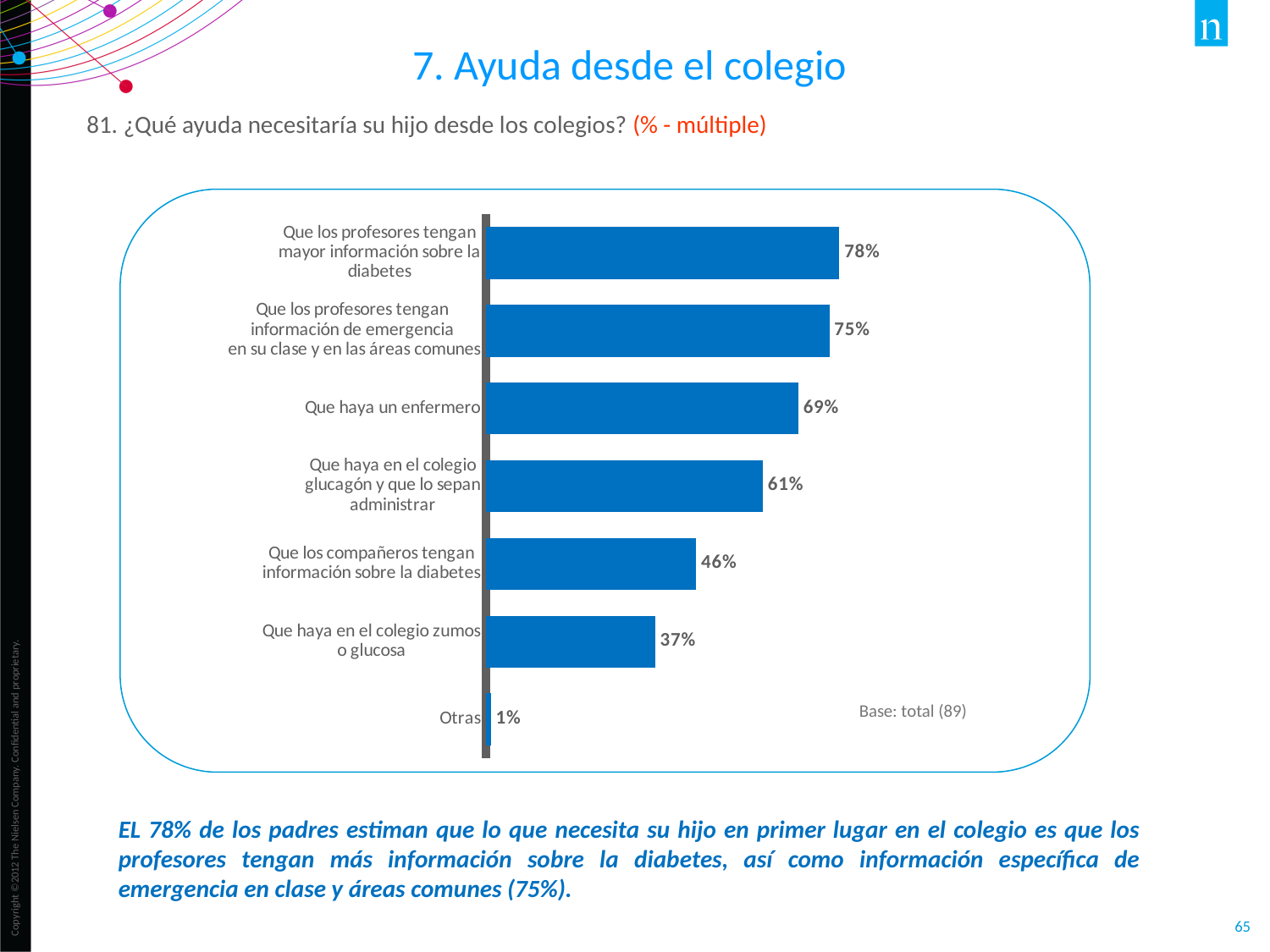
What is the value for "Otras"? 1% What base (sample size) is stated on the chart? total (89) Which category has the lowest value? Otras What is the value for "Que haya en el colegio zumos o glucosa"? 37% What is the value for "Que los compañeros tengan información sobre la diabetes"? 46% What is the difference between "Que haya un enfermero" and "Que haya en el colegio glucagón y que lo sepan administrar"? 8% What is the difference between "Que los profesores tengan mayor información sobre la diabetes" and "Que los profesores tengan información de emergencia en su clase y en las áreas comunes"? 3% How many categories are shown in the chart? 7 What is the value for "Que haya un enfermero"? 69% Which is larger: "Que haya en el colegio glucagón y que lo sepan administrar" or "Que los compañeros tengan información sobre la diabetes"? Que haya en el colegio glucagón y que lo sepan administrar What kind of chart is shown on the slide? Bar chart Which category has the highest value? Que los profesores tengan mayor información sobre la diabetes